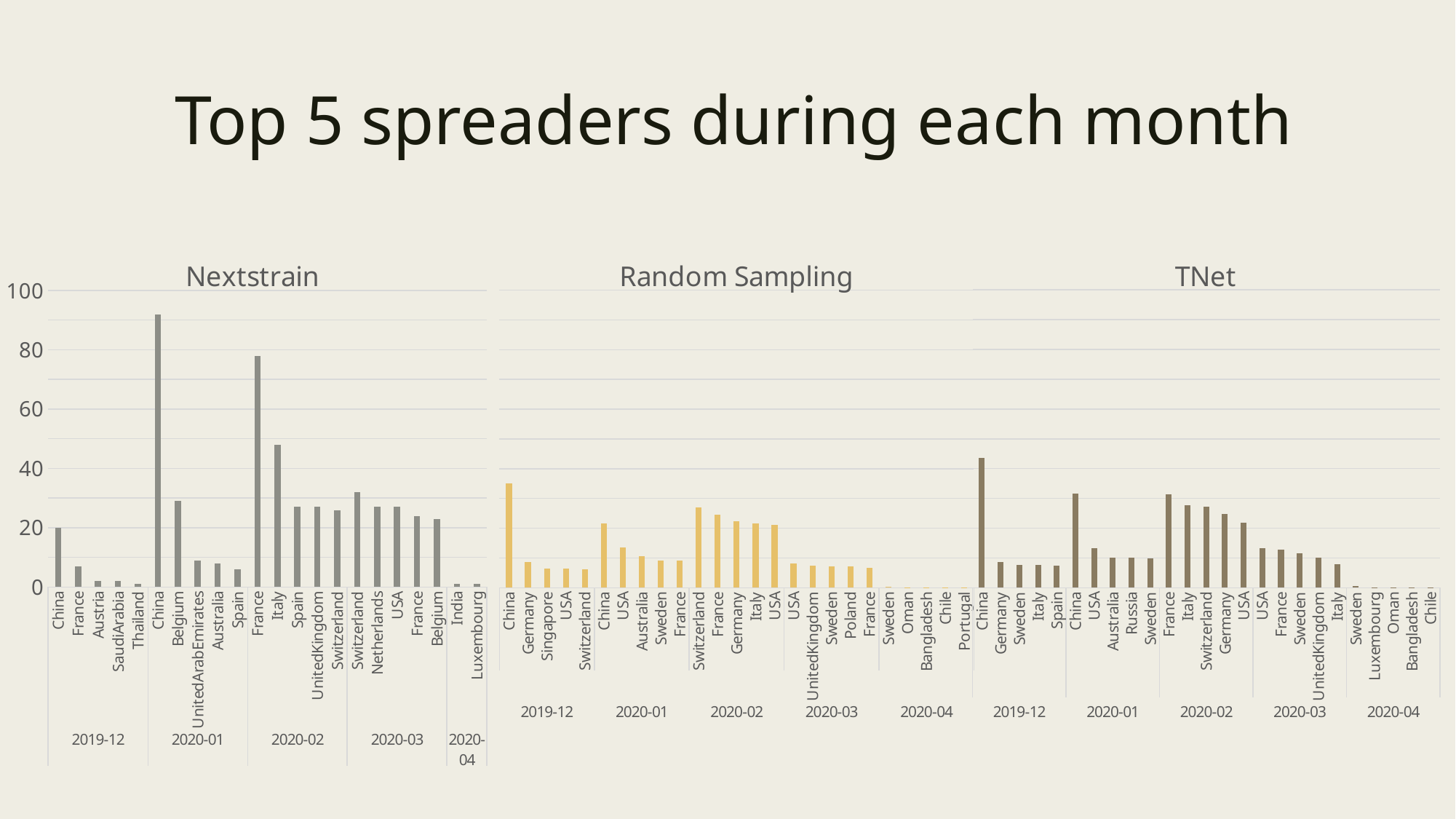
In the TNet chart, is the value for China in 2019-12 greater or less than 20? greater In the Random Sampling chart, is the value for China in 2019-12 greater or less than 20? greater What are the titles of the three charts on the slide? Nextstrain, Random Sampling, TNet In the TNet chart, which bar is the highest? China (2019-12) In the Random Sampling chart, which bar is the highest? China (2019-12) What kind of chart is the Nextstrain chart? bar chart In the Nextstrain chart, which is larger: China in 2020-01 or France in 2020-02? China in 2020-01 In the Nextstrain chart, which bar is the highest? China (2020-01) In the Nextstrain chart, is the value for France in 2020-02 greater or less than 60? greater In the TNet chart, which is larger: China in 2019-12 or China in 2020-01? China in 2019-12 How many months are shown along the x axis of the Random Sampling chart? 5